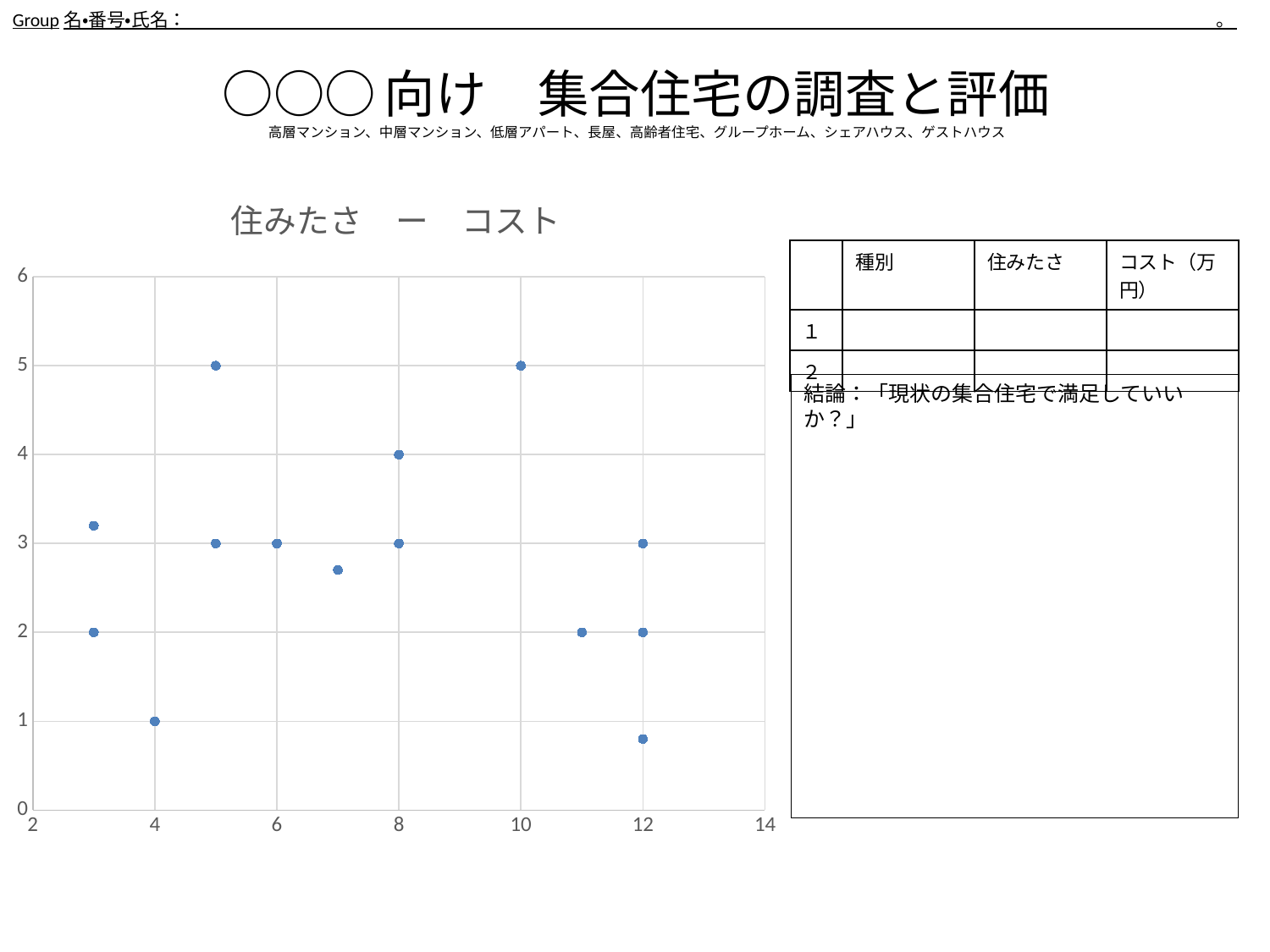
How many data points are plotted in the chart? 14 Is the vertical value of the lowest point at x = 12 greater or less than 2? less Is the vertical value of the point at x = 7 greater or less than 4? less What is the title of the chart? 住みたさ ー コスト How many points are plotted at x = 12? 3 Is the vertical value of the point at x = 4 greater or less than 2? less What kind of chart is shown on the slide? scatter chart What is the highest value shown on the vertical axis of the chart? 6 What is the vertical value of the point plotted at x = 10? 5 Which has the larger vertical value: the point at x = 10 or the point at x = 11? the point at x = 10 What is the vertical value of the point plotted at x = 4? 1